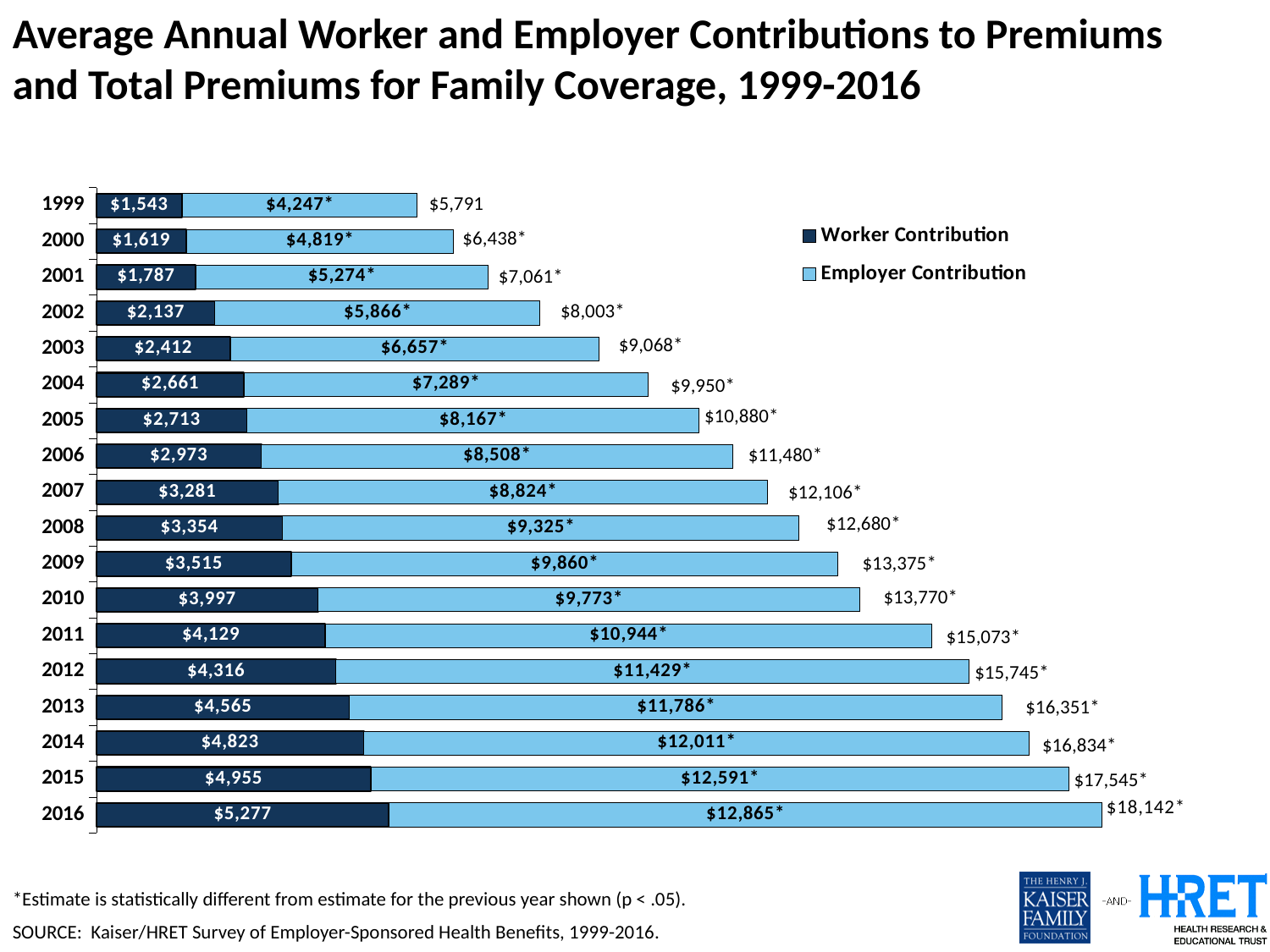
What kind of chart is shown on the slide? Stacked bar chart Which year has the lowest Worker Contribution? 1999 Do total premiums rise or fall from 1999 to 2016? Rise Which year has the highest total premium? 2016 What is the difference between the Employer Contribution in 2016 and in 2015? $274 What is the Employer Contribution for 1999? $4,247* How many years are shown in the chart? 18 What is the Worker Contribution for 2016? $5,277 Which is larger, the Worker Contribution in 2008 or in 2009? 2009 What is the total premium shown for 2010? $13,770* How much larger is the Worker Contribution in 2016 than in 1999? $3,734 How many series does the legend list? 2